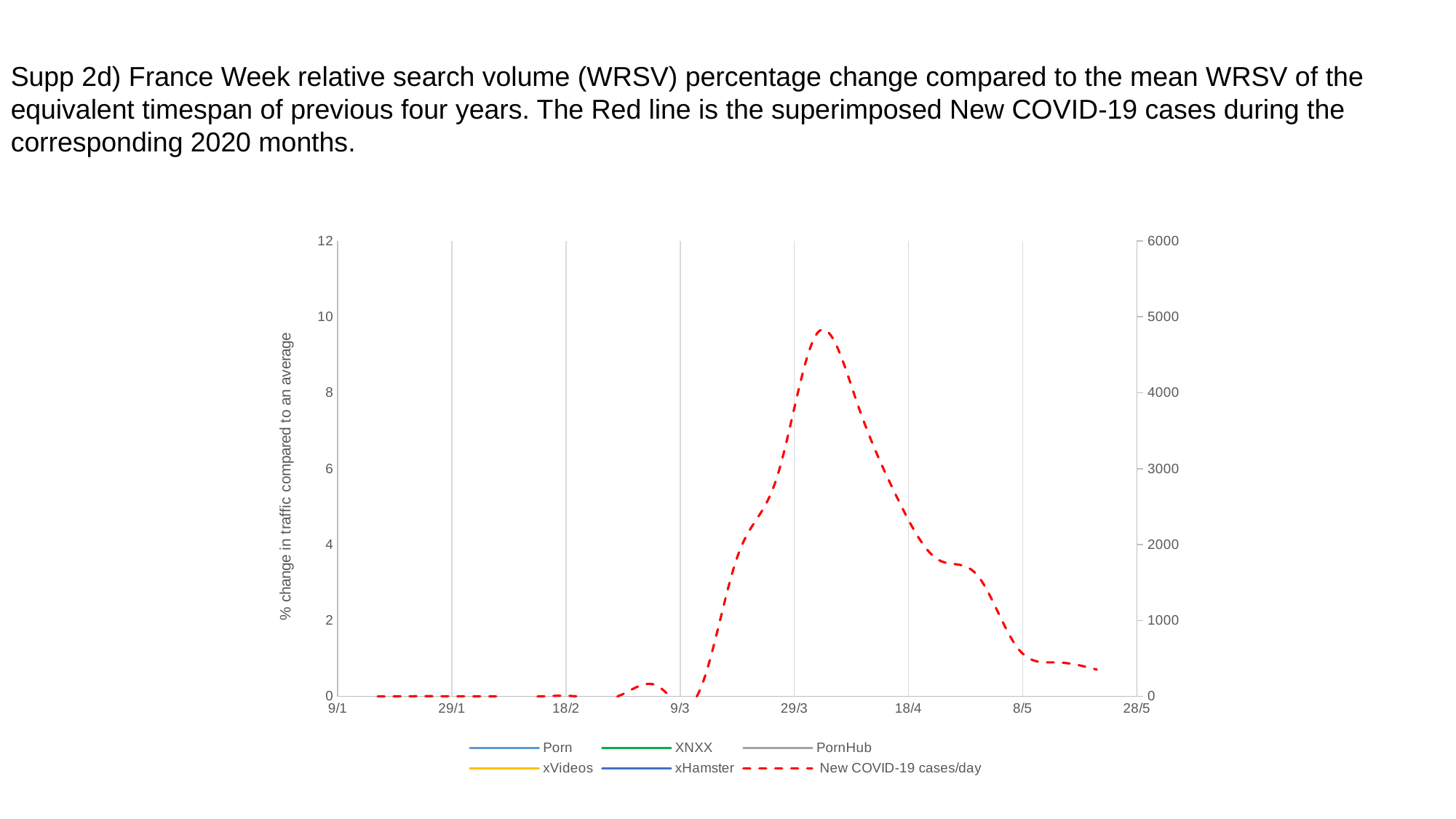
What is the label of the left vertical axis? % change in traffic compared to an average How many date ticks are shown on the x axis? 8 How many series does the legend list? 6 Is the value of the New COVID-19 cases/day line at 9/3 greater or less than 1000 on the right axis? less What kind of chart is shown on the slide? line chart Is the value of the New COVID-19 cases/day line at 18/4 greater or less than 2000 on the right axis? greater Is the value of the New COVID-19 cases/day line at 8/5 greater or less than 1000 on the right axis? less Is the New COVID-19 cases/day value larger at 29/3 or at 8/5? 29/3 Does the New COVID-19 cases/day line rise or fall between 18/4 and 8/5? fall Does the New COVID-19 cases/day line rise or fall between 9/3 and 29/3? rise Which series is drawn as a red dashed line? New COVID-19 cases/day